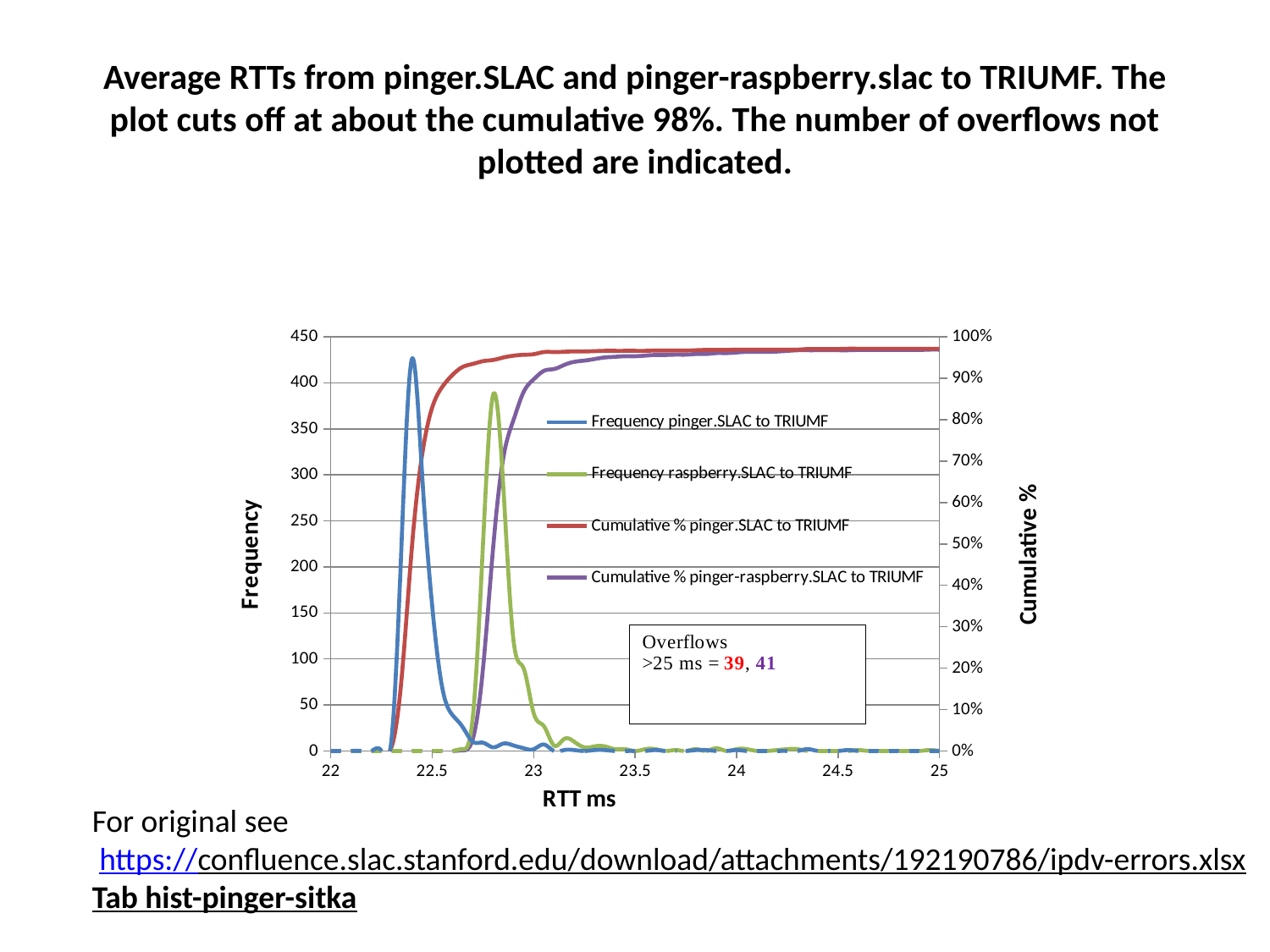
How many overflows above 25 ms are indicated for pinger-raspberry.SLAC to TRIUMF? 41 Is the Cumulative % pinger.SLAC to TRIUMF value at 23 ms greater or less than 90%? greater What is the label of the right-hand y axis? Cumulative % Which frequency series peaks at a lower RTT, pinger.SLAC to TRIUMF or raspberry.SLAC to TRIUMF? Frequency pinger.SLAC to TRIUMF How many overflows above 25 ms are indicated for pinger.SLAC to TRIUMF? 39 Is the peak value of the Frequency pinger.SLAC to TRIUMF series greater or less than 400? greater Do the Cumulative % series rise or fall as RTT increases along the x axis? rise Which frequency series reaches the higher peak, pinger.SLAC to TRIUMF or raspberry.SLAC to TRIUMF? Frequency pinger.SLAC to TRIUMF What is the label of the x axis? RTT ms What kind of chart is shown on the slide? line chart Is the peak value of the Frequency raspberry.SLAC to TRIUMF series greater or less than 350? greater How many series does the legend list? 4